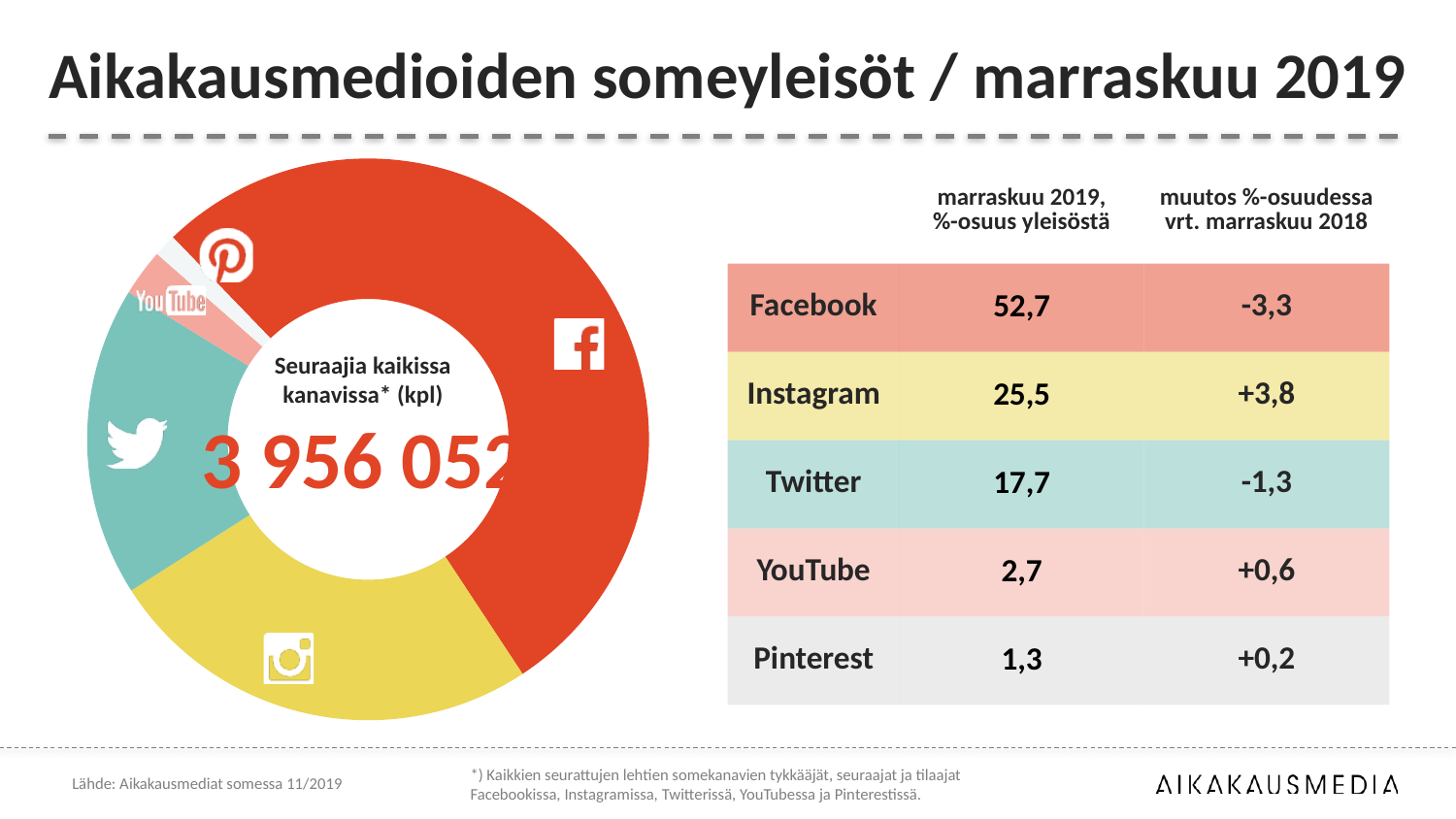
What kind of chart is shown on the left of the slide? pie chart (donut) Which channel's share is larger, Twitter or YouTube? Twitter What is the title of the slide? Aikakausmedioiden someyleisöt / marraskuu 2019 What total number of followers is printed in the centre of the donut chart? 3 956 052 What is the change in Twitter's percentage share compared with November 2018? -1,3 How many slices does the donut chart have? 5 Which channel had the largest increase in percentage share compared with November 2018? Instagram What is the difference between Facebook's and Instagram's share of the audience in November 2019? 27,2 Which channel has the smallest slice of the donut chart? Pinterest What is Facebook's share of the audience in November 2019 according to the table? 52,7 What is Instagram's share of the audience in November 2019 according to the table? 25,5 Which channel has the largest slice of the donut chart? Facebook